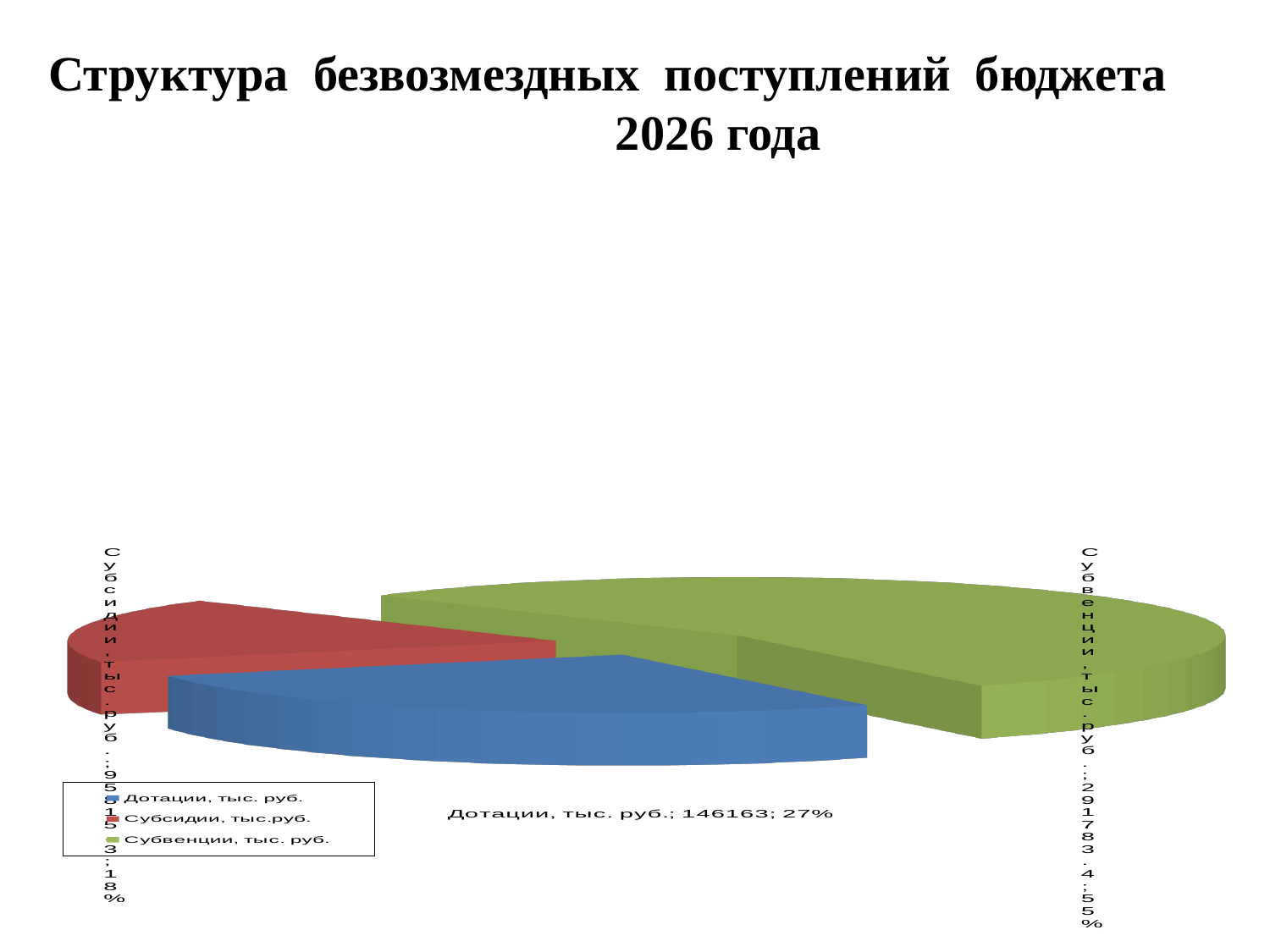
What is the value shown for Субвенции, тыс. руб.? 291783.4 How many slices does the pie chart have? 3 What share of the pie does Дотации, тыс. руб. represent? 27% What share of the pie does Субсидии, тыс.руб. represent? 18% Which category has the smallest slice of the pie? Субсидии, тыс.руб. What kind of chart is shown on the slide? pie chart What share of the pie does Субвенции, тыс. руб. represent? 55% How many entries does the legend list? 3 Which category has the largest slice of the pie? Субвенции, тыс. руб. Which is larger, the value for Дотации or the value for Субвенции? Субвенции What is the value shown for Дотации, тыс. руб.? 146163 What is the title of the slide? Структура безвозмездных поступлений бюджета 2026 года